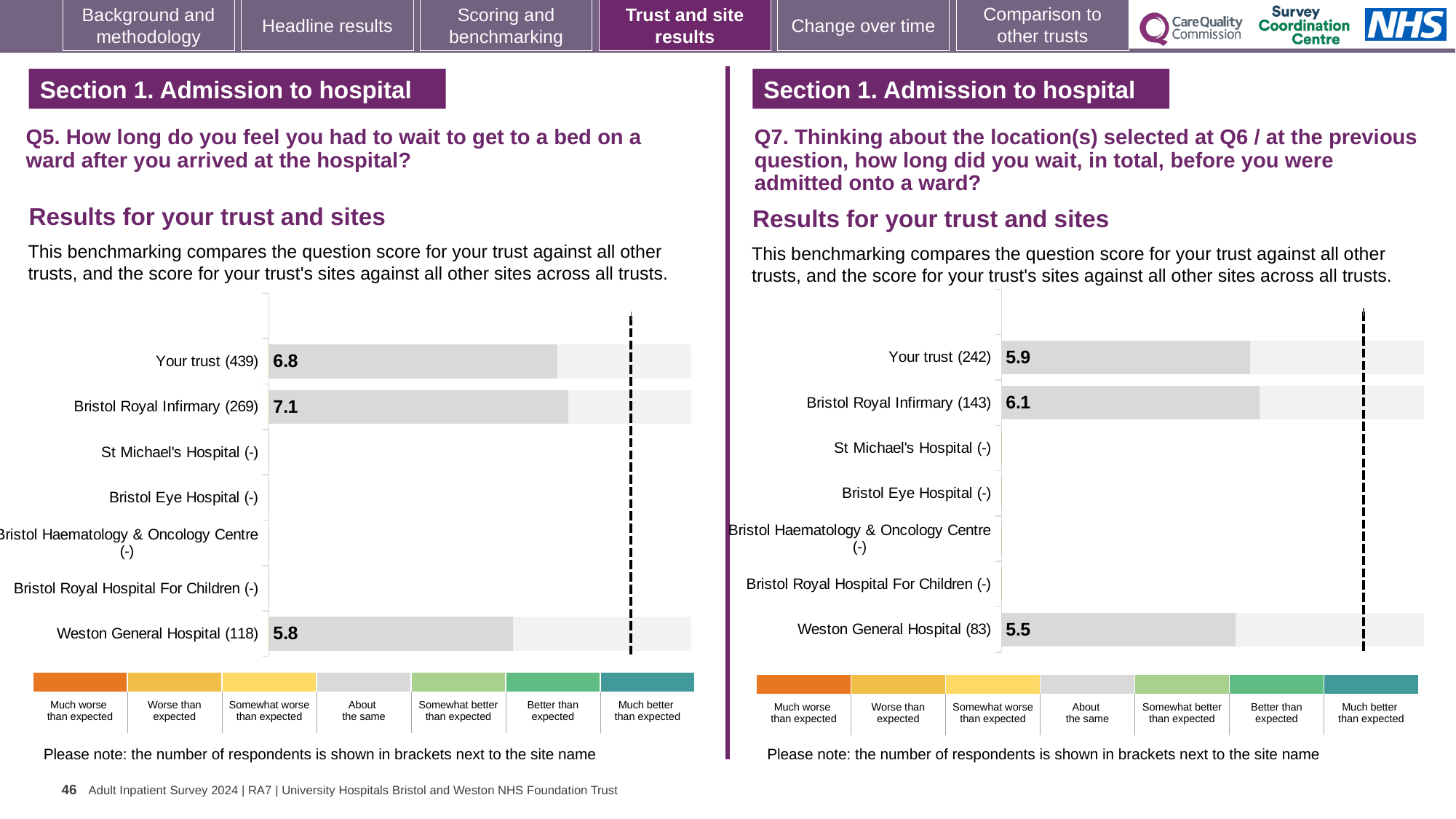
On the Q7 chart (right), which site has the lowest score among those with a plotted value? Weston General Hospital On the Q5 chart (left), which site has the highest score? Bristol Royal Infirmary How many categories (rows) are listed on the Q5 chart (left)? 7 On the Q5 chart (left), what is the score for Bristol Royal Infirmary (269)? 7.1 What kind of chart is the Q7 chart (right)? bar chart On the Q5 chart (left), what is the score for Your trust (439)? 6.8 On the Q7 chart (right), is the score for Bristol Royal Infirmary larger or smaller than the score for Your trust? larger On the Q7 chart (right), what is the score for Bristol Royal Infirmary (143)? 6.1 On the Q7 chart (right), what is the score for Weston General Hospital (83)? 5.5 On the Q5 chart (left), what is the score for Weston General Hospital (118)? 5.8 On the Q5 chart (left), what is the difference between the Bristol Royal Infirmary score and the Weston General Hospital score? 1.3 On the Q7 chart (right), what is the score for Your trust (242)? 5.9